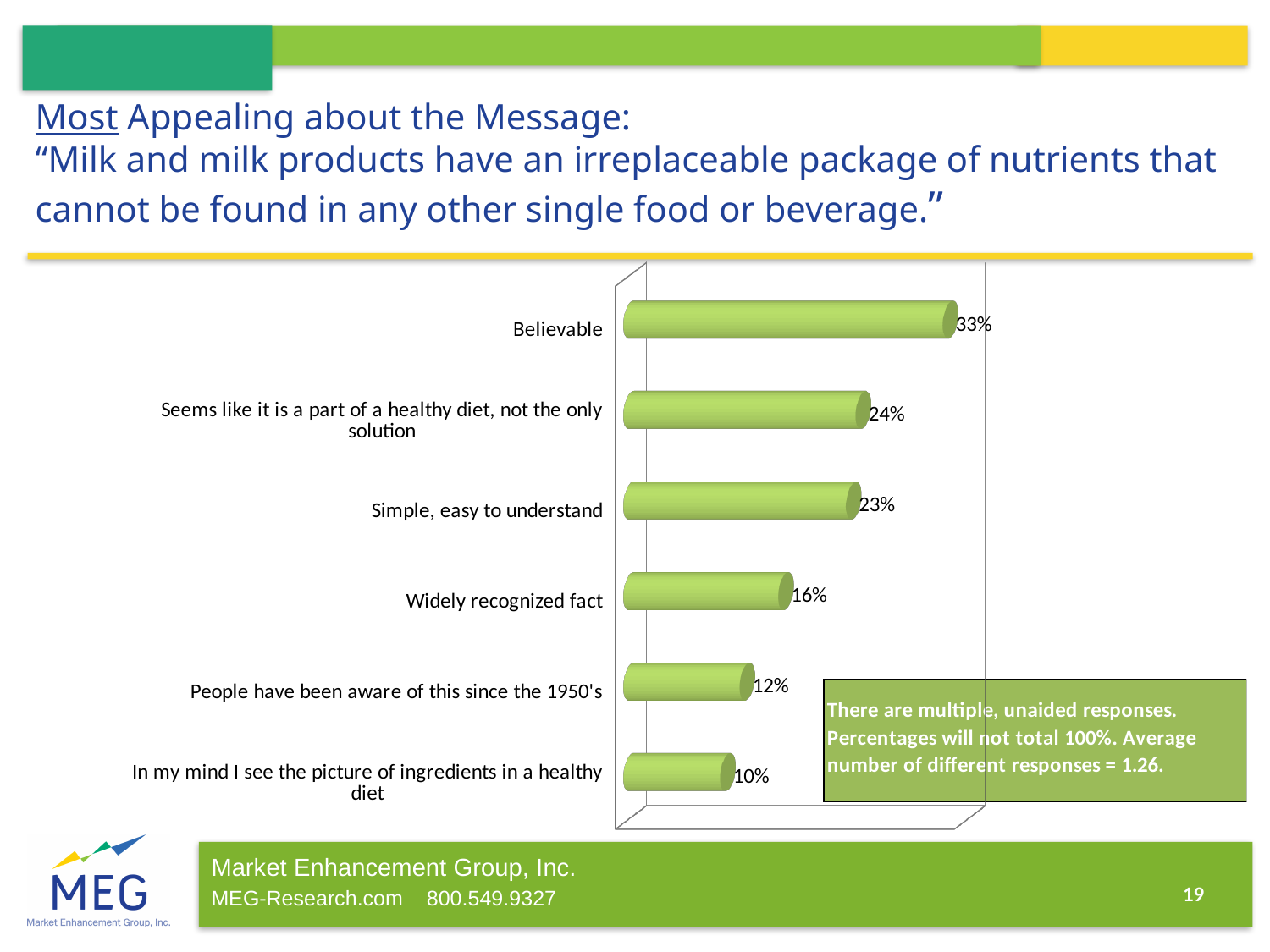
Which is larger: the value for 'Simple, easy to understand' or 'Widely recognized fact'? Simple, easy to understand What kind of chart is shown on the slide? Bar chart What is the value for 'In my mind I see the picture of ingredients in a healthy diet'? 10% What is the difference between 'Widely recognized fact' and 'People have been aware of this since the 1950's'? 4% What is the difference between the values for 'Believable' and 'Seems like it is a part of a healthy diet, not the only solution'? 9% Which category has the highest value? Believable According to the note on the chart, what is the average number of different responses? 1.26 What is the value for 'Widely recognized fact'? 16% How many categories are shown in the chart? 6 What is the value for 'Simple, easy to understand'? 23% Which category has the lowest value? In my mind I see the picture of ingredients in a healthy diet What percentage of respondents found the message 'Believable'? 33%